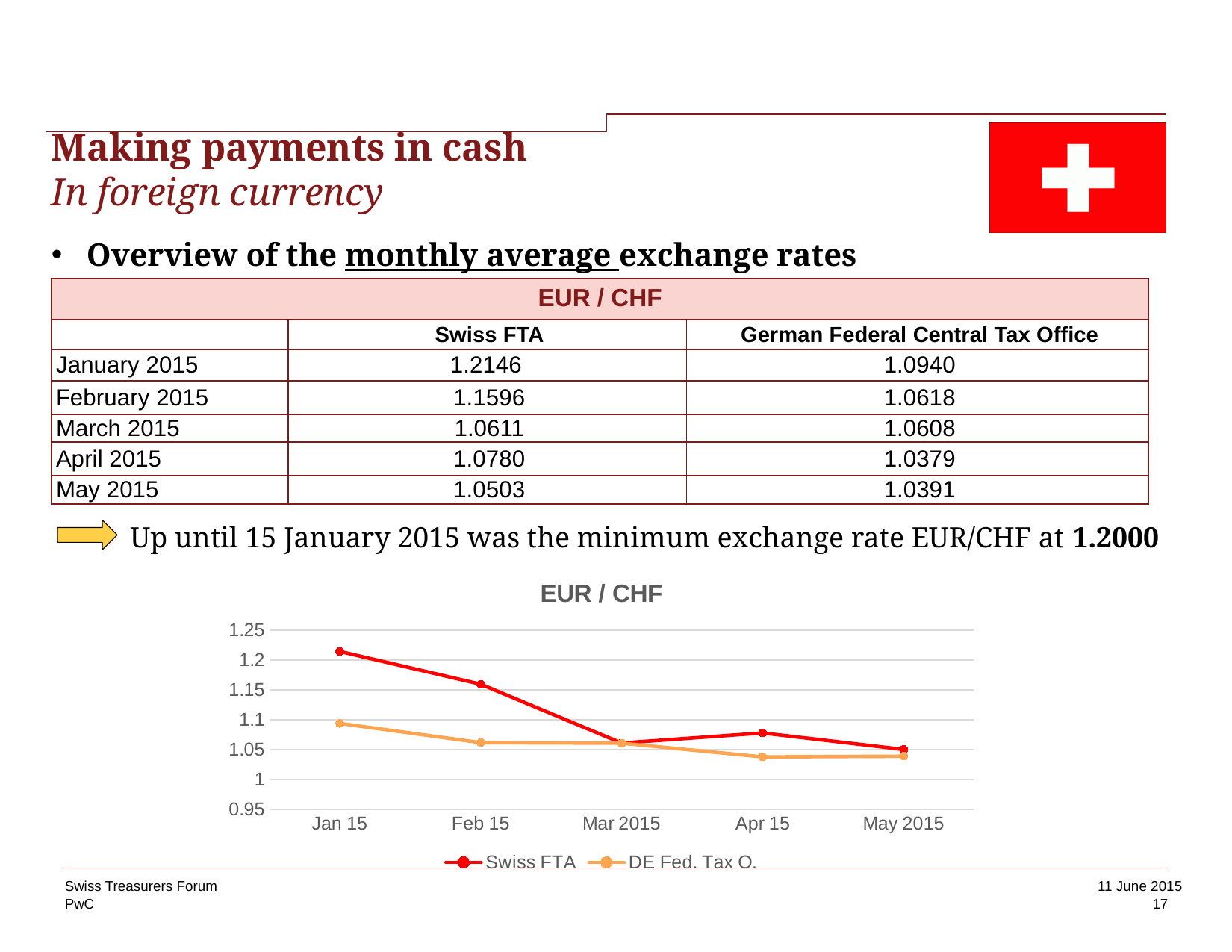
In the EUR / CHF chart, is the Swiss FTA value for Jan 15 greater or less than 1.2? greater In the EUR / CHF chart, at which month is the Swiss FTA series lowest? May 2015 What is the Swiss FTA EUR / CHF rate for January 2015? 1.2146 In the EUR / CHF chart, which series has the larger value at Jan 15, Swiss FTA or DE Fed. Tax O.? Swiss FTA In the EUR / CHF chart, is the DE Fed. Tax O. value for Apr 15 greater or less than 1.05? less What kind of chart is shown at the bottom of the slide? line chart In the EUR / CHF chart, does the Swiss FTA line rise or fall from Jan 15 to Mar 2015? fall What colour is the Swiss FTA line in the EUR / CHF chart? red What is the difference between the Swiss FTA and German Federal Central Tax Office EUR / CHF rates for January 2015? 0.1206 How many series does the legend of the EUR / CHF chart list? 2 How many months are plotted along the x axis of the EUR / CHF chart? 5 In the EUR / CHF chart, at which month is the Swiss FTA series highest? Jan 15